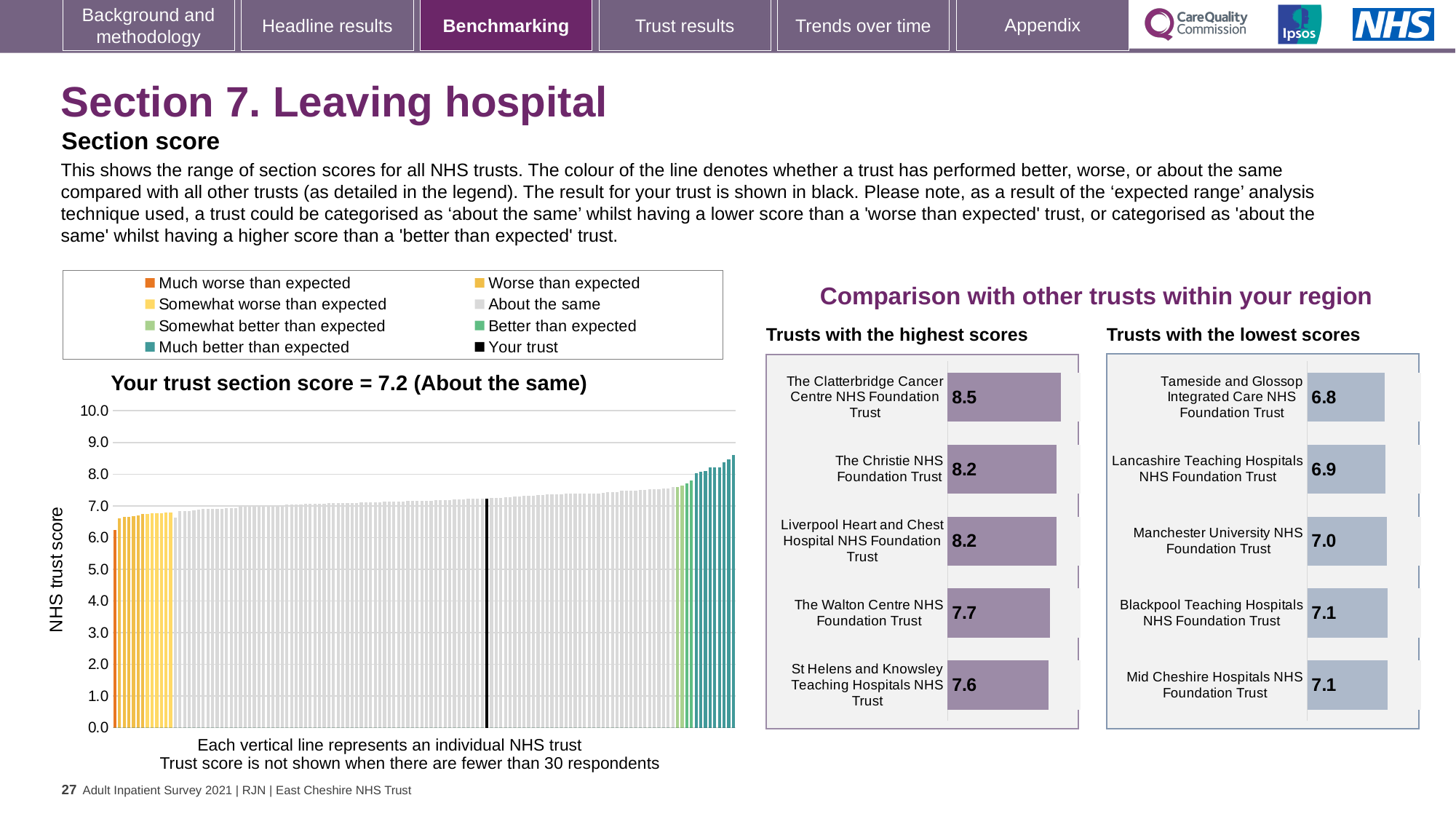
On the 'Trusts with the highest scores' chart, what is the score for The Clatterbridge Cancer Centre NHS Foundation Trust? 8.5 What kind of chart is the main section score chart on the left? Bar chart On the main section score chart on the left, do the trust scores rise or fall from left to right along the x axis? Rise On the 'Trusts with the lowest scores' chart, which trust has the lowest score? Tameside and Glossop Integrated Care NHS Foundation Trust On the 'Trusts with the lowest scores' chart, which is larger: the score for Lancashire Teaching Hospitals NHS Foundation Trust or Blackpool Teaching Hospitals NHS Foundation Trust? Blackpool Teaching Hospitals NHS Foundation Trust On the 'Trusts with the lowest scores' chart, what is the score for Manchester University NHS Foundation Trust? 7.0 How many entries does the legend above the main section score chart list? 8 On the 'Trusts with the highest scores' chart, how many trusts are listed? 5 On the 'Trusts with the highest scores' chart, what is the difference between the scores of The Clatterbridge Cancer Centre NHS Foundation Trust and St Helens and Knowsley Teaching Hospitals NHS Trust? 0.9 On the main section score chart on the left, what is the section score for your trust? 7.2 On the 'Trusts with the lowest scores' chart, what is the difference between the scores of Mid Cheshire Hospitals NHS Foundation Trust and Tameside and Glossop Integrated Care NHS Foundation Trust? 0.3 On the 'Trusts with the highest scores' chart, which trust has the lowest score shown? St Helens and Knowsley Teaching Hospitals NHS Trust